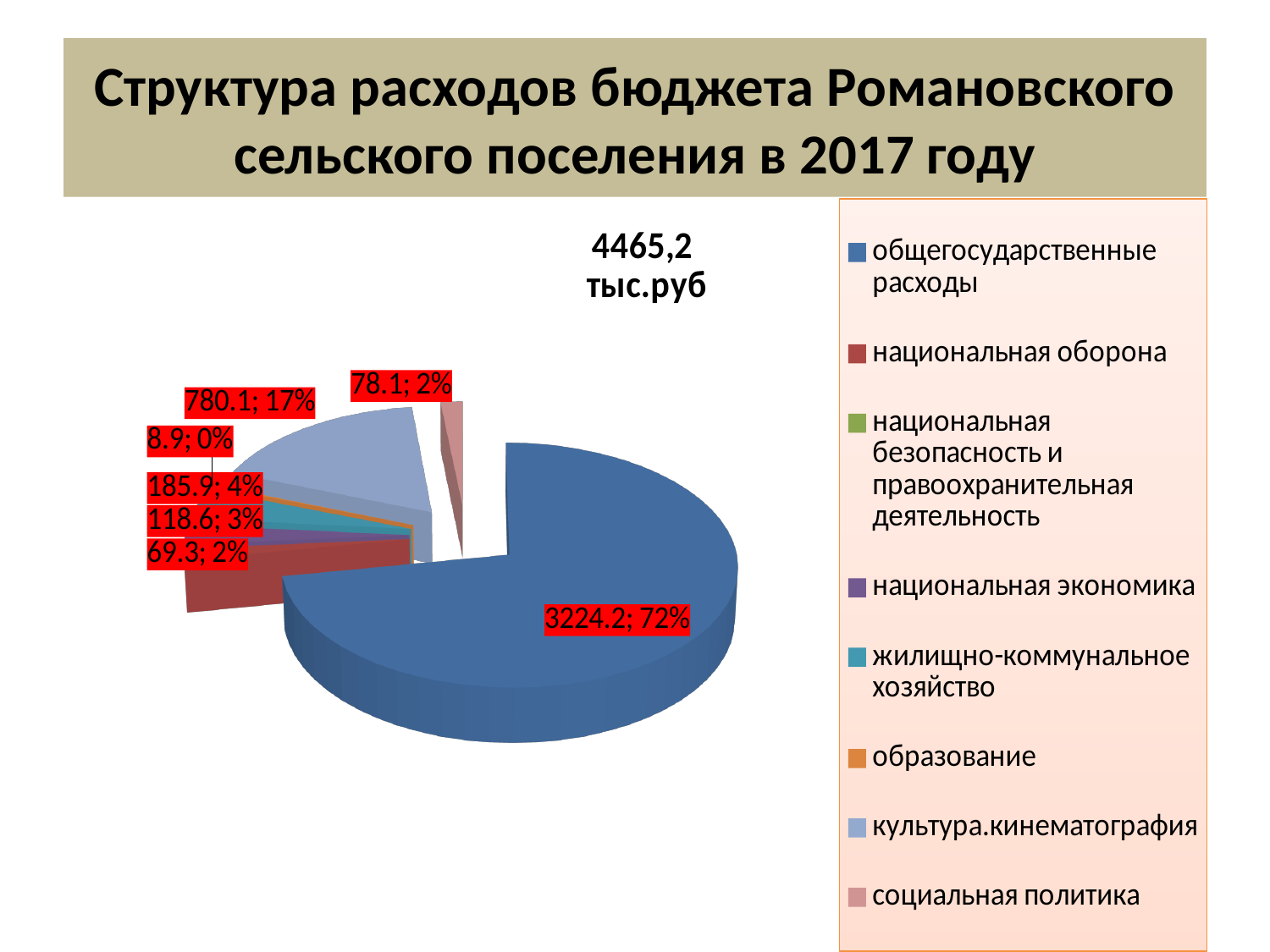
Which is larger, культура.кинематография or социальная политика? культура.кинематография What kind of chart is shown on the slide? pie chart Which category has the largest slice of the pie? общегосударственные расходы What share of the pie does культура.кинематография take? 17% What is the value shown for социальная политика? 78.1 What share of the pie does общегосударственные расходы take? 72% What is the value shown for общегосударственные расходы? 3224.2 What is the title of the slide? Структура расходов бюджета Романовского сельского поселения в 2017 году What is the value shown for культура.кинематография? 780.1 What is the difference between the values for общегосударственные расходы and культура.кинематография? 2444.1 How many categories does the legend list? 8 What total amount is printed above the chart? 4465,2 тыс.руб